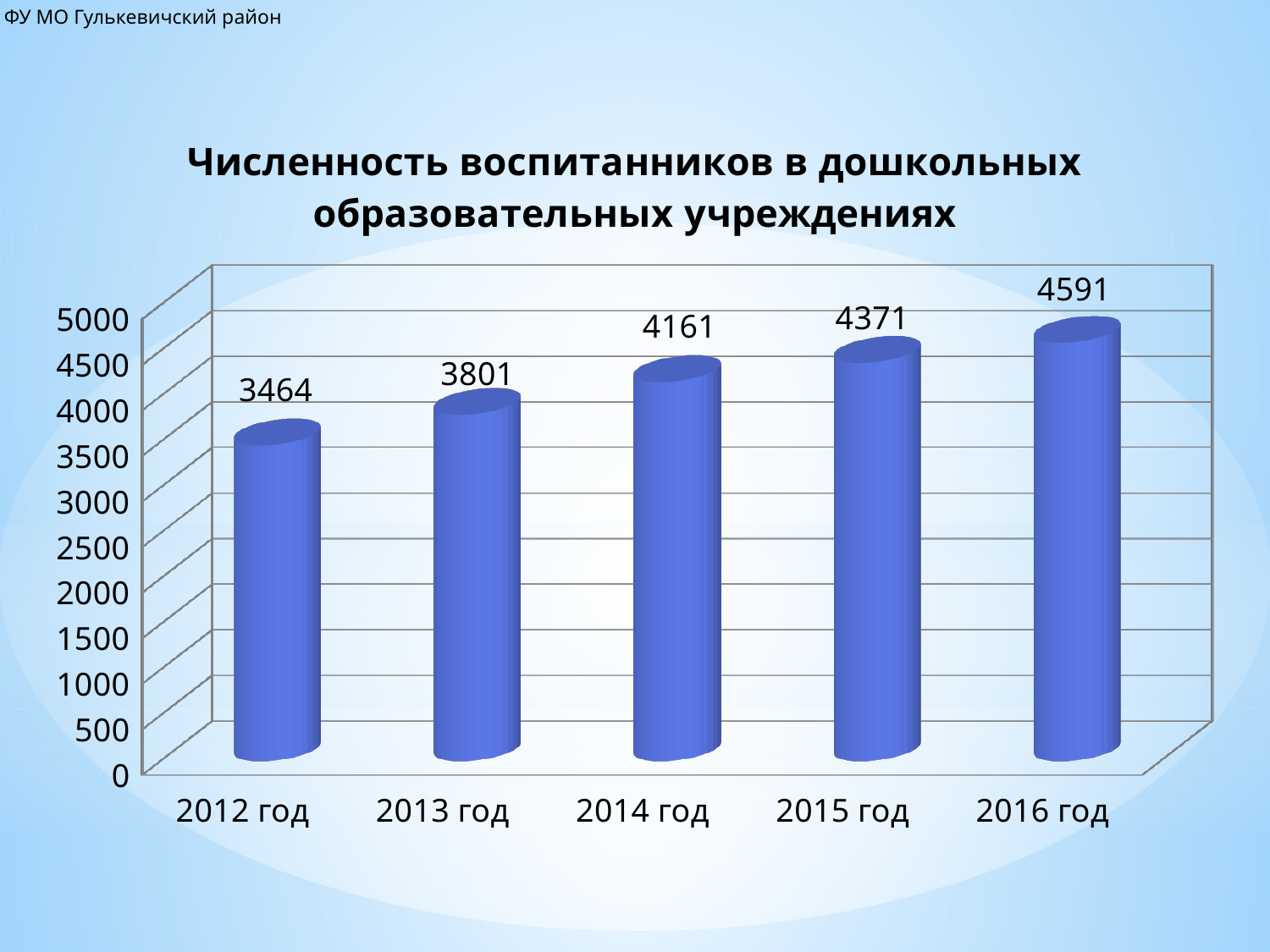
How many years are shown on the chart? 5 Which year has the highest value? 2016 год Which is larger, the value for 2013 год or the value for 2015 год? 2015 год What is the difference between the values for 2016 год and 2012 год? 1127 Which year has the lowest value? 2012 год What kind of chart is this? bar chart Is the value for 2013 год greater or less than 3500? greater What is the difference between the values for 2015 год and 2014 год? 210 What is the value for 2016 год? 4591 What is the value for 2014 год? 4161 What is the value for 2012 год? 3464 Do the values rise or fall from 2012 год to 2016 год? rise